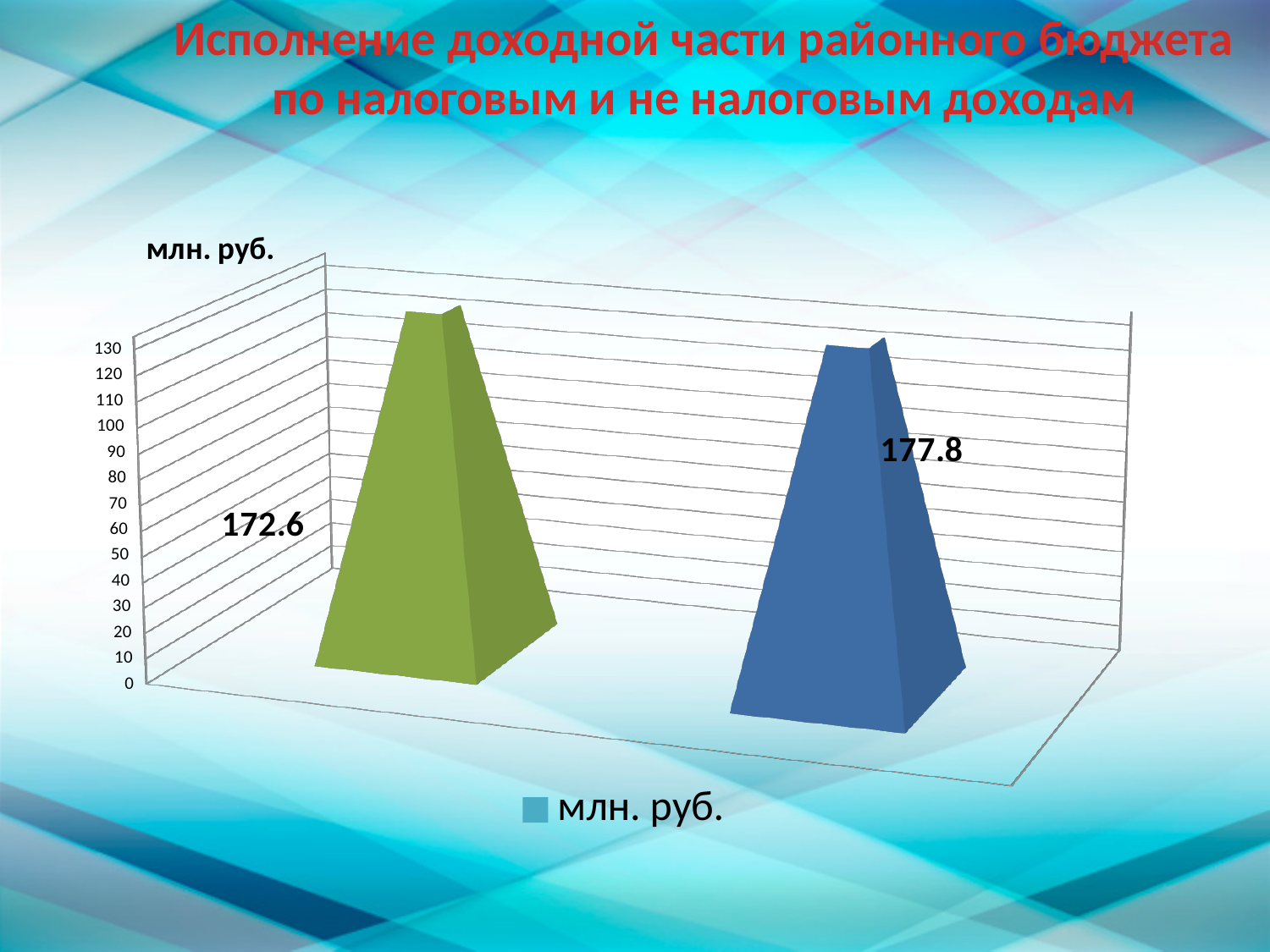
How many bars are plotted on the chart? 2 What is the data label on the left (green) bar? 172.6 What is the highest tick value shown on the vertical axis? 130 What kind of chart is shown on the slide? bar chart What is the difference between the two labelled values, 177.8 and 172.6? 5.2 How many series does the legend list? 1 What is the data label on the right (blue) bar? 177.8 What entry does the legend show? млн. руб. According to the data labels, which bar has the larger value, the green one or the blue one? the blue one (177.8) What is the title of the slide? Исполнение доходной части районного бюджета по налоговым и не налоговым доходам